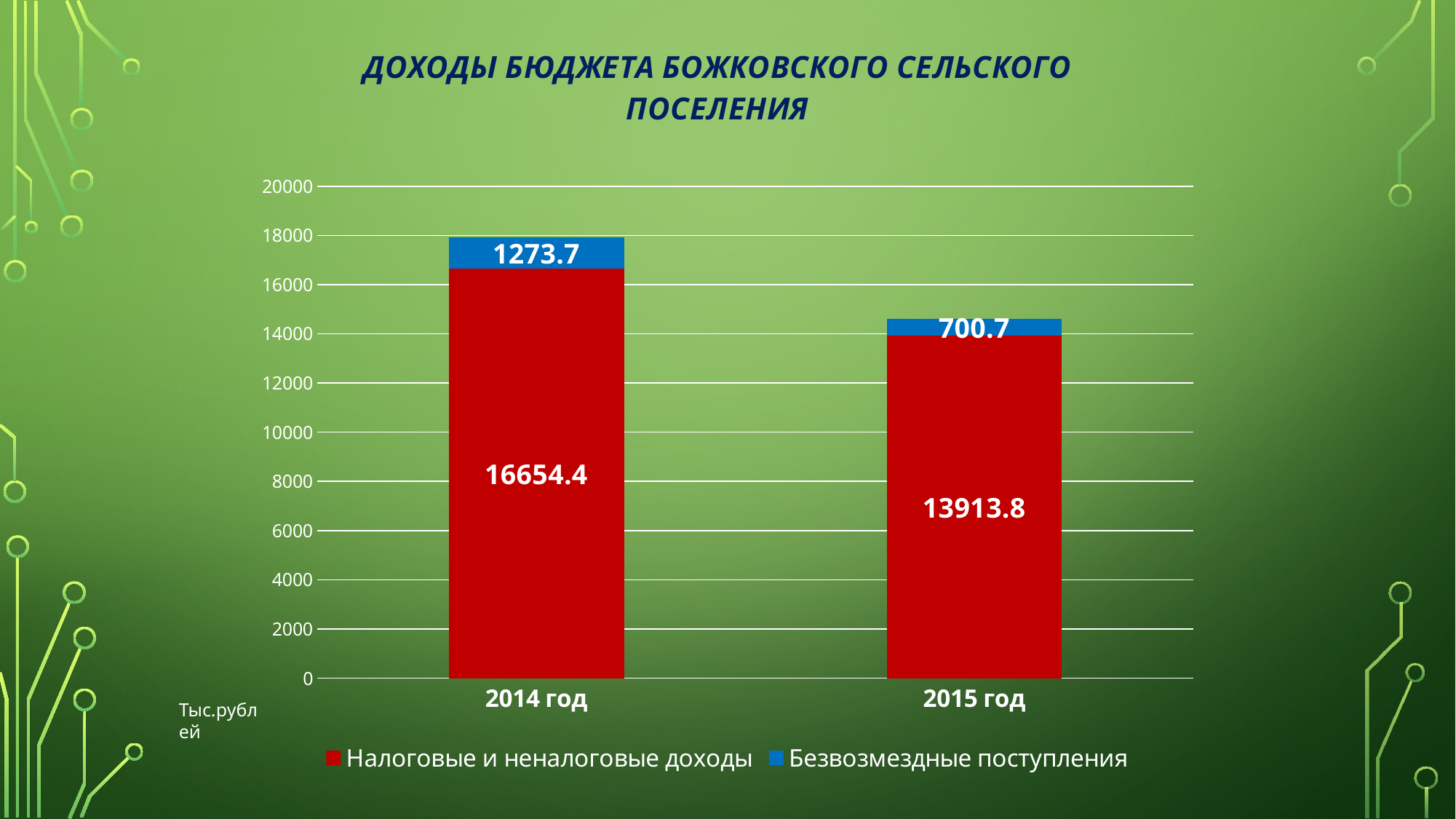
How many series does the legend list? 2 What is the total height of the stacked bar for 2014 год? 17928.1 What is the value of Безвозмездные поступления for 2014 год? 1273.7 What is the value of Безвозмездные поступления for 2015 год? 700.7 What is the value of Налоговые и неналоговые доходы for 2014 год? 16654.4 Which colour represents Безвозмездные поступления in the chart? Blue What is the total height of the stacked bar for 2015 год? 14614.5 What is the difference between Налоговые и неналоговые доходы in 2014 год and 2015 год? 2740.6 Which year has the higher value for Налоговые и неналоговые доходы? 2014 год What is the value of Налоговые и неналоговые доходы for 2015 год? 13913.8 What kind of chart is shown on the slide? Stacked bar chart Which year has the lower value for Безвозмездные поступления? 2015 год